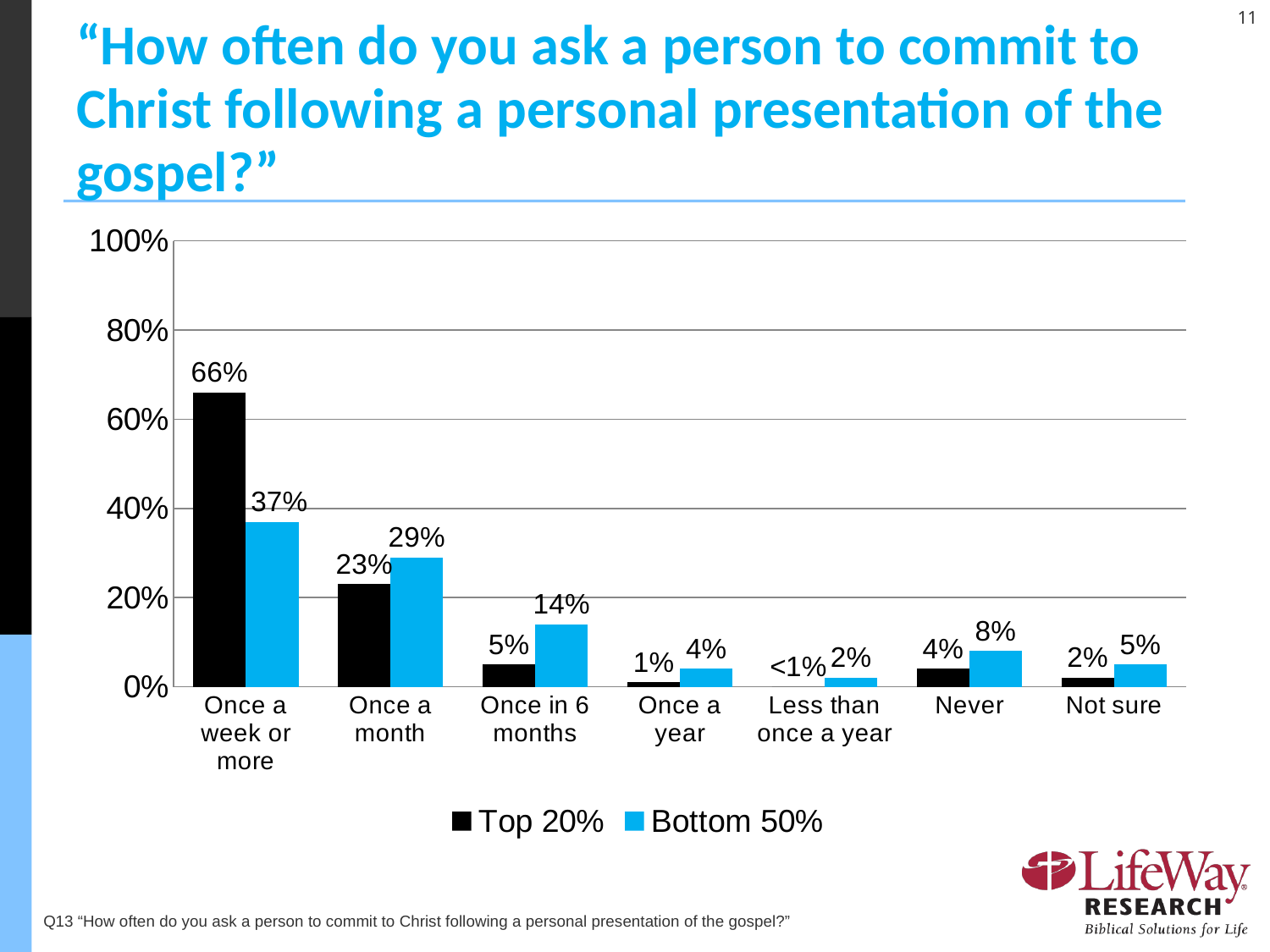
For "Once in 6 months", which series has the larger value, Top 20% or Bottom 50%? Bottom 50% How many categories are shown on the x axis? 7 Is the Top 20% value for "Once a week or more" greater or less than 60%? greater What is the value for "Once a week or more" in the Top 20% series? 66% Which category has the lowest value in the Bottom 50% series? Less than once a year What is the difference between the Top 20% and Bottom 50% values for "Once a week or more"? 29% Which category has the highest value in the Top 20% series? Once a week or more What is the value for "Less than once a year" in the Top 20% series? <1% How many series does the legend list? 2 What kind of chart is shown on the slide? Bar chart What is the value for "Once a month" in the Bottom 50% series? 29% What is the value for "Never" in the Bottom 50% series? 8%